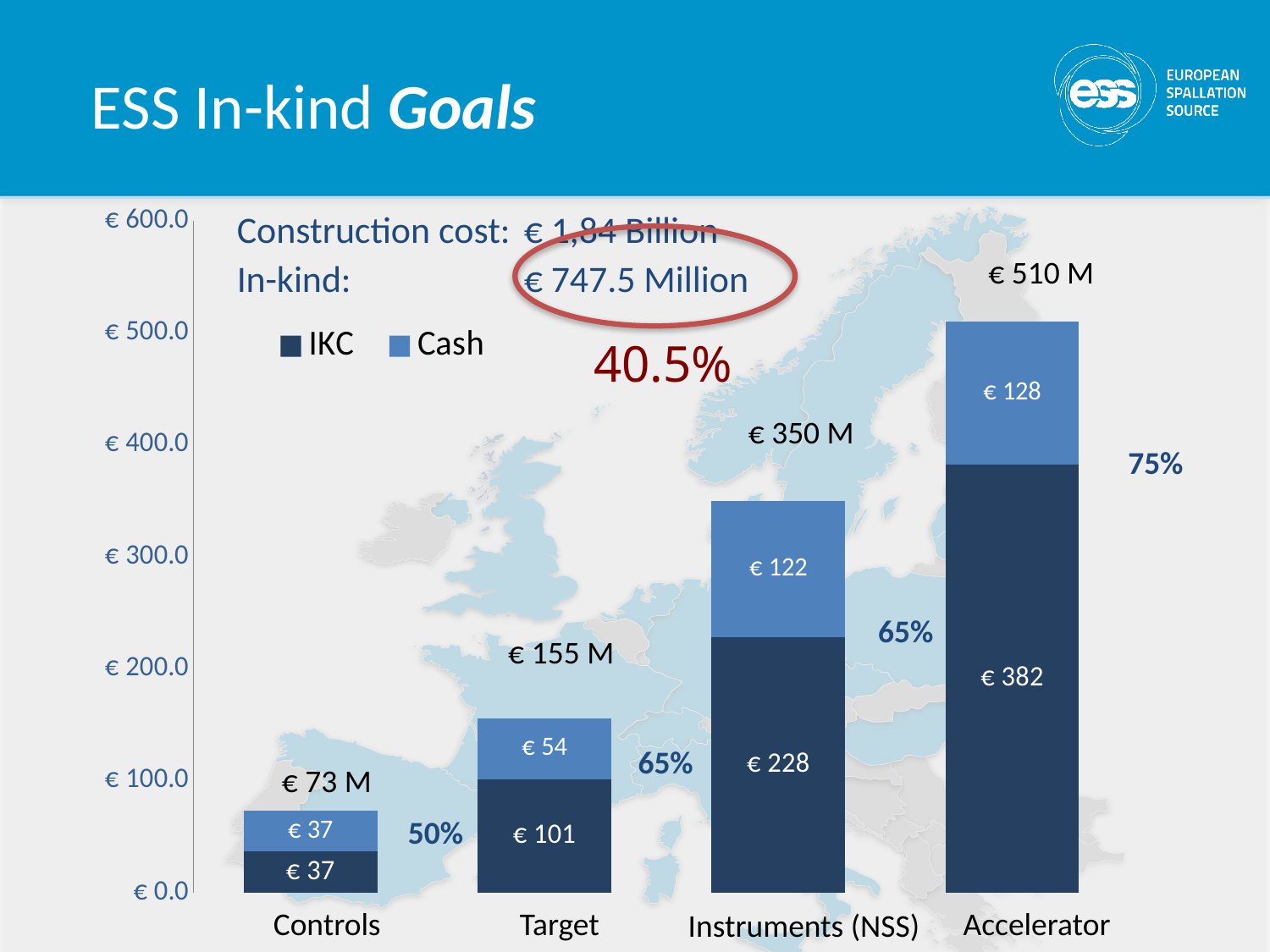
Which category has the highest total? Accelerator How many series does the legend list? 2 What is the total labelled above the Controls bar? € 73 M How many categories are shown on the x axis? 4 Which is larger, the Cash value for Accelerator or the Cash value for Instruments (NSS)? Accelerator What is the Cash value for Target? € 54 What is the IKC value for Instruments (NSS)? € 228 What kind of chart is shown? Stacked bar chart What is the total labelled above the Instruments (NSS) bar? € 350 M Which category has the lowest total? Controls What is the difference between the IKC values for Accelerator and Instruments (NSS)? € 154 What is the IKC value for Accelerator? € 382